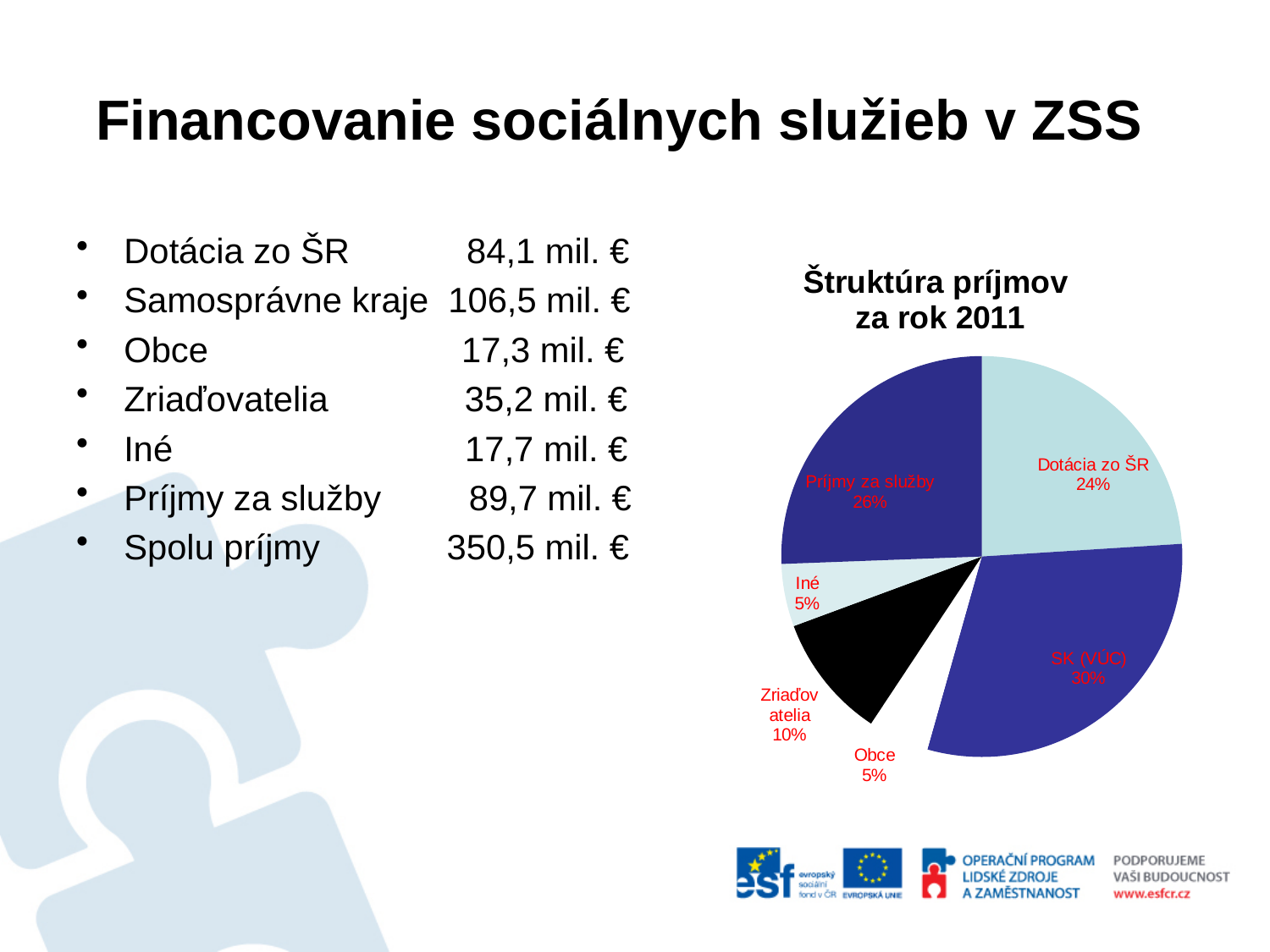
What share of the pie does Príjmy za služby have? 26% What kind of chart is shown on the slide? pie chart What share of the pie does Dotácia zo ŠR have? 24% What share of the pie does Zriaďovatelia have? 10% What is the combined share of the Obce and Iné slices? 10% What is the title of the pie chart? Štruktúra príjmov za rok 2011 How many slices does the pie chart have? 6 Which slice of the pie chart is the largest? SK (VÚC) What is the difference in percentage points between the SK (VÚC) slice and the Zriaďovatelia slice? 20 Which is larger in the pie chart, Dotácia zo ŠR or Príjmy za služby? Príjmy za služby